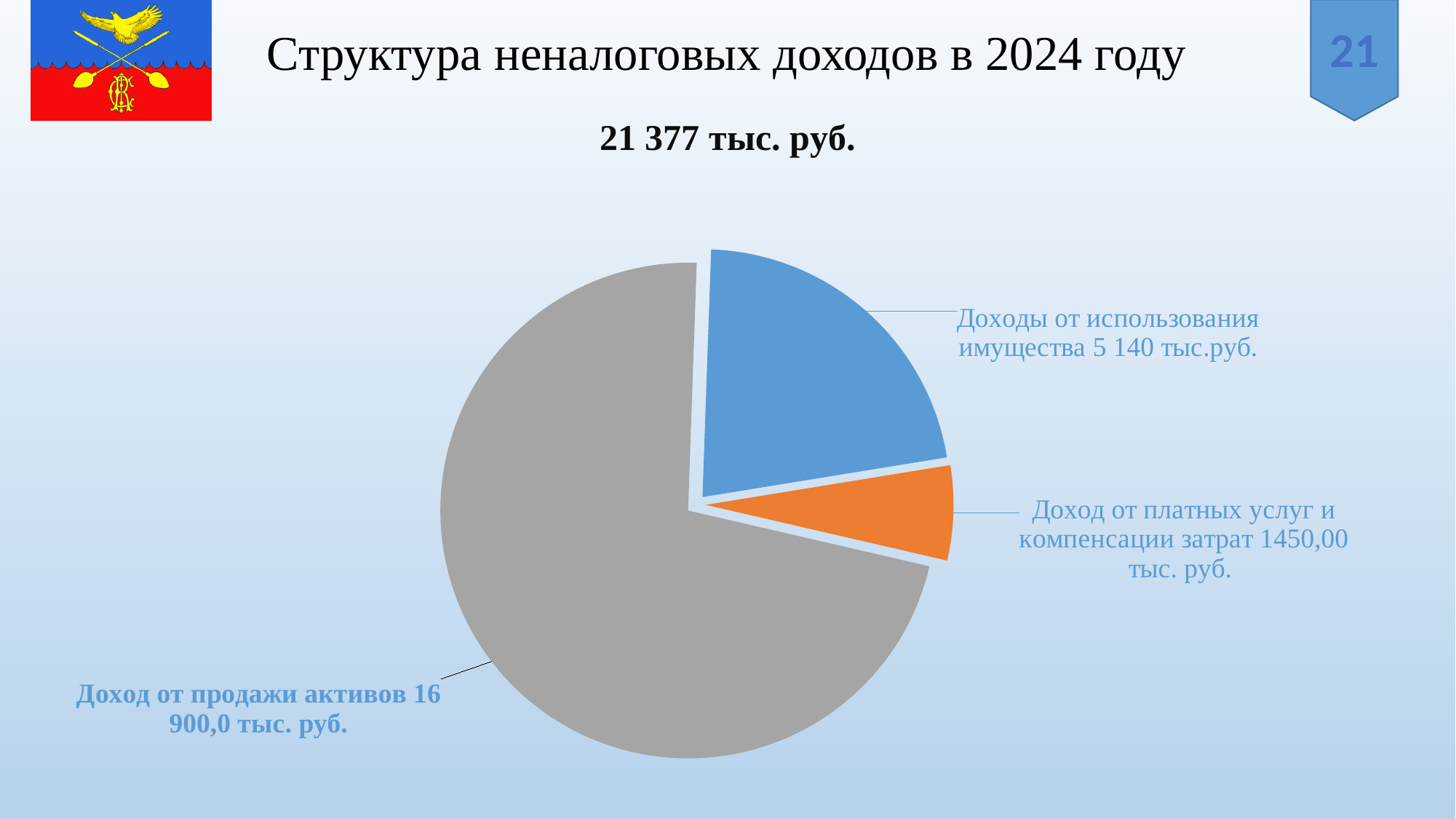
What is the difference between "Доходы от использования имущества" and "Доход от платных услуг и компенсации затрат"? 3 690 тыс. руб. What is the title of the chart on the slide? 21 377 тыс. руб. What colour is the slice for "Доход от продажи активов"? Grey What kind of chart is shown on the slide? Pie chart Which is larger: "Доходы от использования имущества" or "Доход от платных услуг и компенсации затрат"? Доходы от использования имущества How many slices does the pie chart have? 3 What is the value for "Доходы от использования имущества"? 5 140 тыс.руб. Which category has the smallest slice of the pie? Доход от платных услуг и компенсации затрат Which category has the largest slice of the pie? Доход от продажи активов What is the difference between "Доход от продажи активов" and "Доходы от использования имущества"? 11 760 тыс. руб. What is the value for "Доход от платных услуг и компенсации затрат"? 1450,00 тыс. руб. What is the value for "Доход от продажи активов"? 16 900,0 тыс. руб.